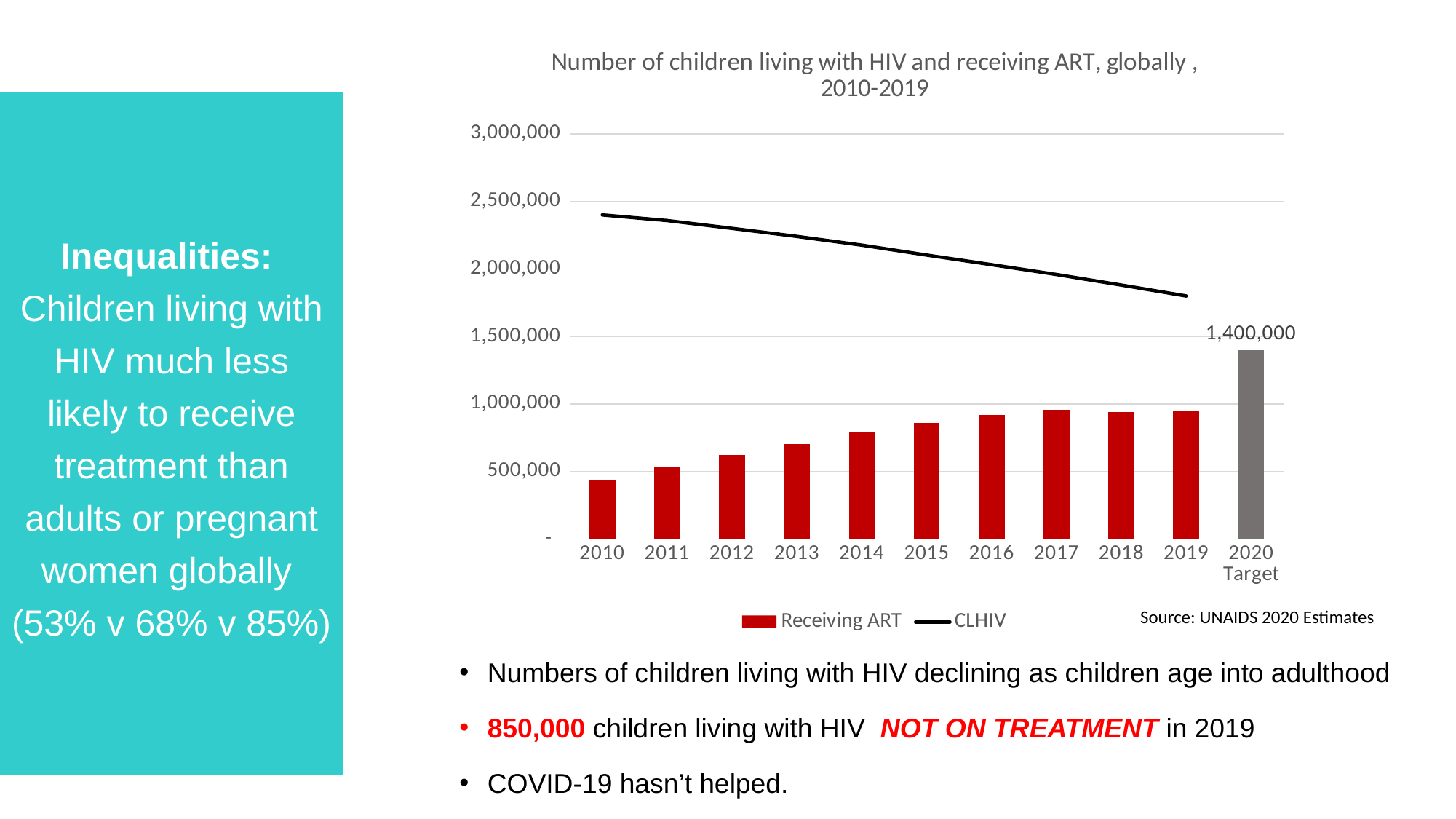
Which year has the lowest Receiving ART bar? 2010 Is the Receiving ART value for 2019 greater or less than 1,000,000? less How many categories are shown on the x axis? 11 Is the CLHIV value for 2010 greater or less than 2,000,000? greater Does the CLHIV line rise or fall from 2010 to 2019? fall How many series does the legend list? 2 Is the Receiving ART value for 2010 greater or less than 500,000? less Which is larger, the Receiving ART value for 2010 or for 2015? 2015 Which category has the tallest bar? 2020 Target What is the value shown for the 2020 Target bar? 1,400,000 What is the source cited for the chart? UNAIDS 2020 Estimates